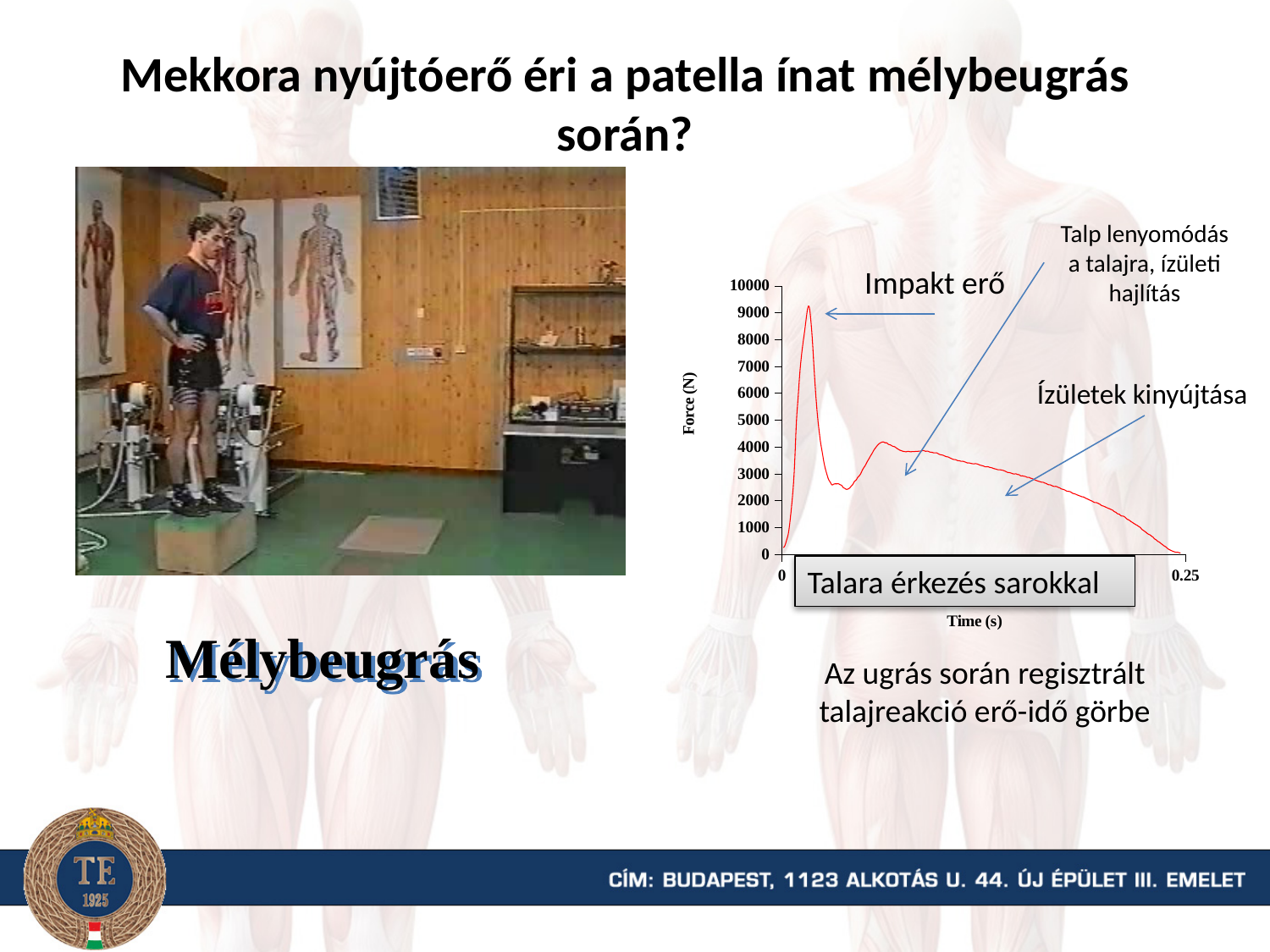
What is the highest value shown on the vertical axis of the chart? 10000 Is the force value at the end of the curve (at 0.25 s) greater or less than 1000? less How many lines (data series) are plotted on the chart? 1 What is the label of the horizontal axis of the chart? Time (s) Is the peak force value on the chart greater or less than 10000? less Which annotation on the chart points to the highest peak of the curve? Impakt erő What kind of chart is shown on the slide? line chart What is the last tick value shown on the horizontal axis of the chart? 0.25 Is the peak force value (the impact force) on the chart greater or less than 8000? greater After the impact peak, does the force curve overall rise or fall as time increases toward 0.25 s? fall